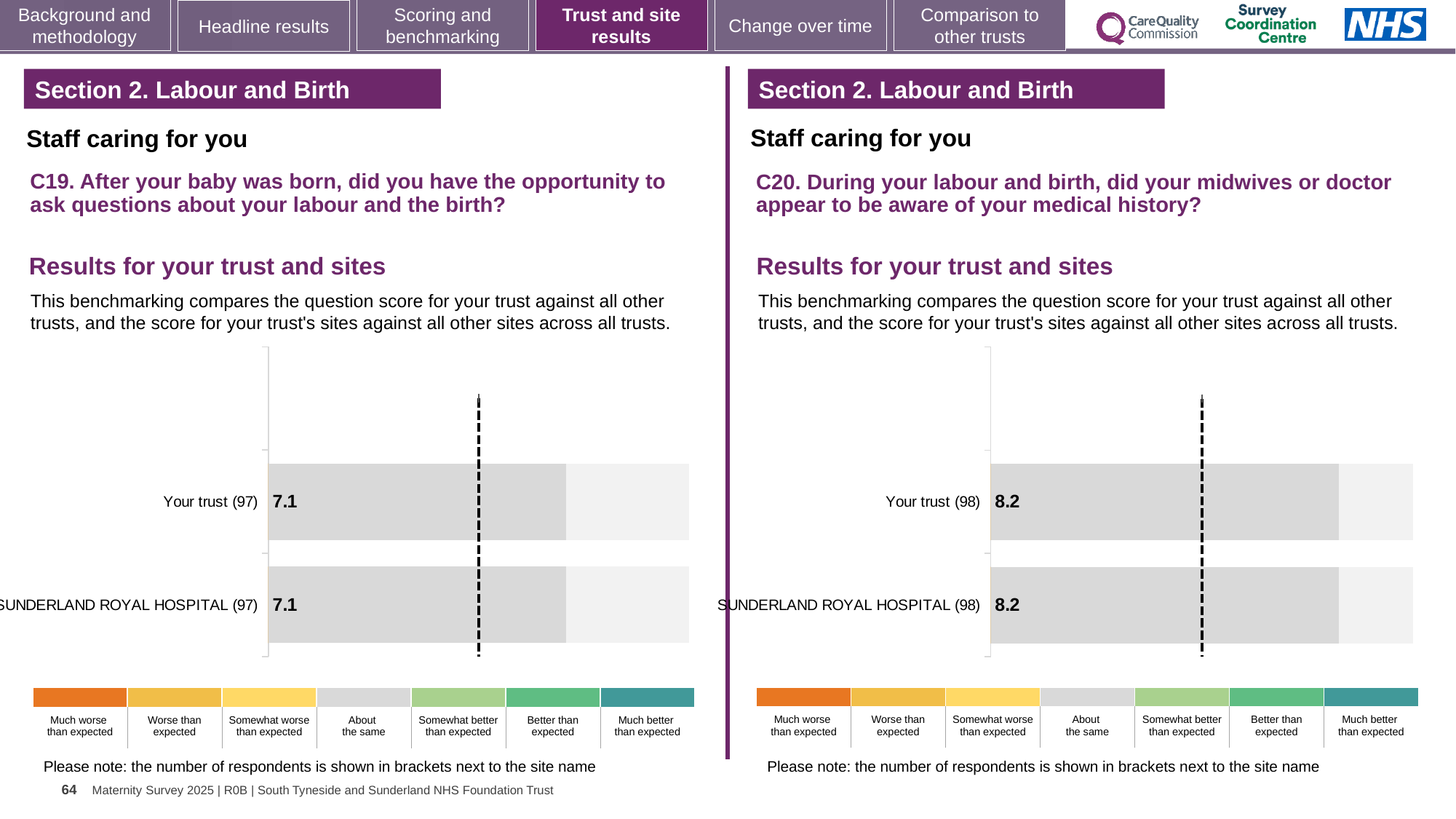
On the C19 chart (left), what is the difference between the Your trust score and the SUNDERLAND ROYAL HOSPITAL score? 0 How many bars are plotted on the C20 chart (right)? 2 How many respondents are shown in brackets for Your trust on the C20 chart (right)? 98 What kind of chart is used on the C19 chart (left)? Bar chart On the C19 chart (left), which legend category does the grey colour of the bars correspond to? About the same How many categories does the colour legend below the C19 chart (left) list? 7 On the C19 chart (left), what is the score for SUNDERLAND ROYAL HOSPITAL? 7.1 On the C20 chart (right), what is the score for SUNDERLAND ROYAL HOSPITAL? 8.2 On the C20 chart (right), what is the score for Your trust? 8.2 How many bars are plotted on the C19 chart (left)? 2 On the C19 chart (left), what is the score for Your trust? 7.1 On the C20 chart (right), what is the difference between the Your trust score and the SUNDERLAND ROYAL HOSPITAL score? 0